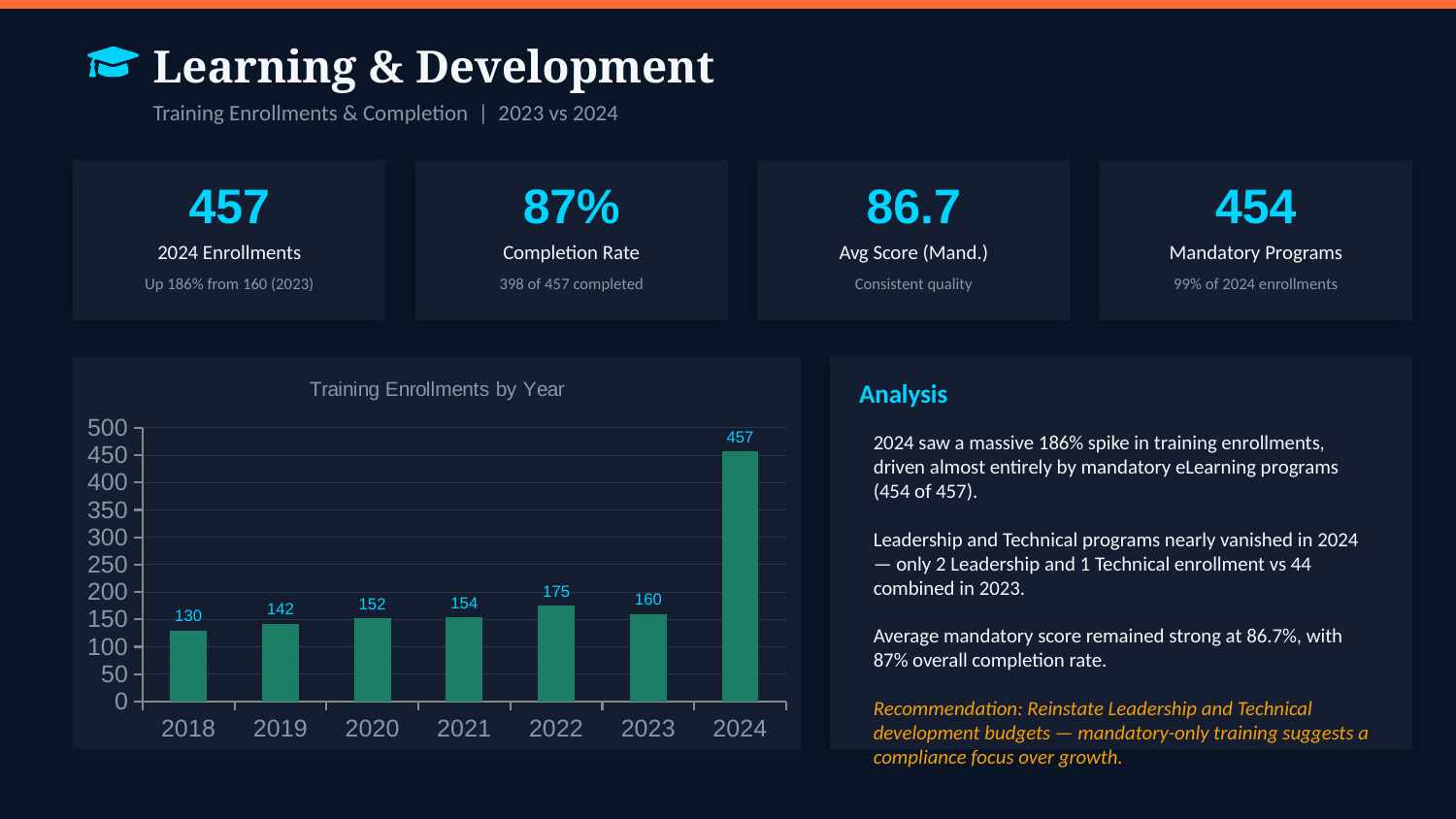
What is the value for 2024 in the Training Enrollments by Year chart? 457 Which year has the highest value in the Training Enrollments by Year chart? 2024 How many years are shown on the x axis of the Training Enrollments by Year chart? 7 What is the title of the chart on the slide? Training Enrollments by Year Is the value for 2020 in the Training Enrollments by Year chart greater or less than 200? less What is the difference between the 2022 and 2021 values in the Training Enrollments by Year chart? 21 Which year has the lowest value in the Training Enrollments by Year chart? 2018 What is the value for 2022 in the Training Enrollments by Year chart? 175 What kind of chart is Training Enrollments by Year? bar chart Which is larger in the Training Enrollments by Year chart, the value for 2022 or the value for 2023? 2022 What is the value for 2018 in the Training Enrollments by Year chart? 130 What is the difference between the 2024 and 2023 values in the Training Enrollments by Year chart? 297